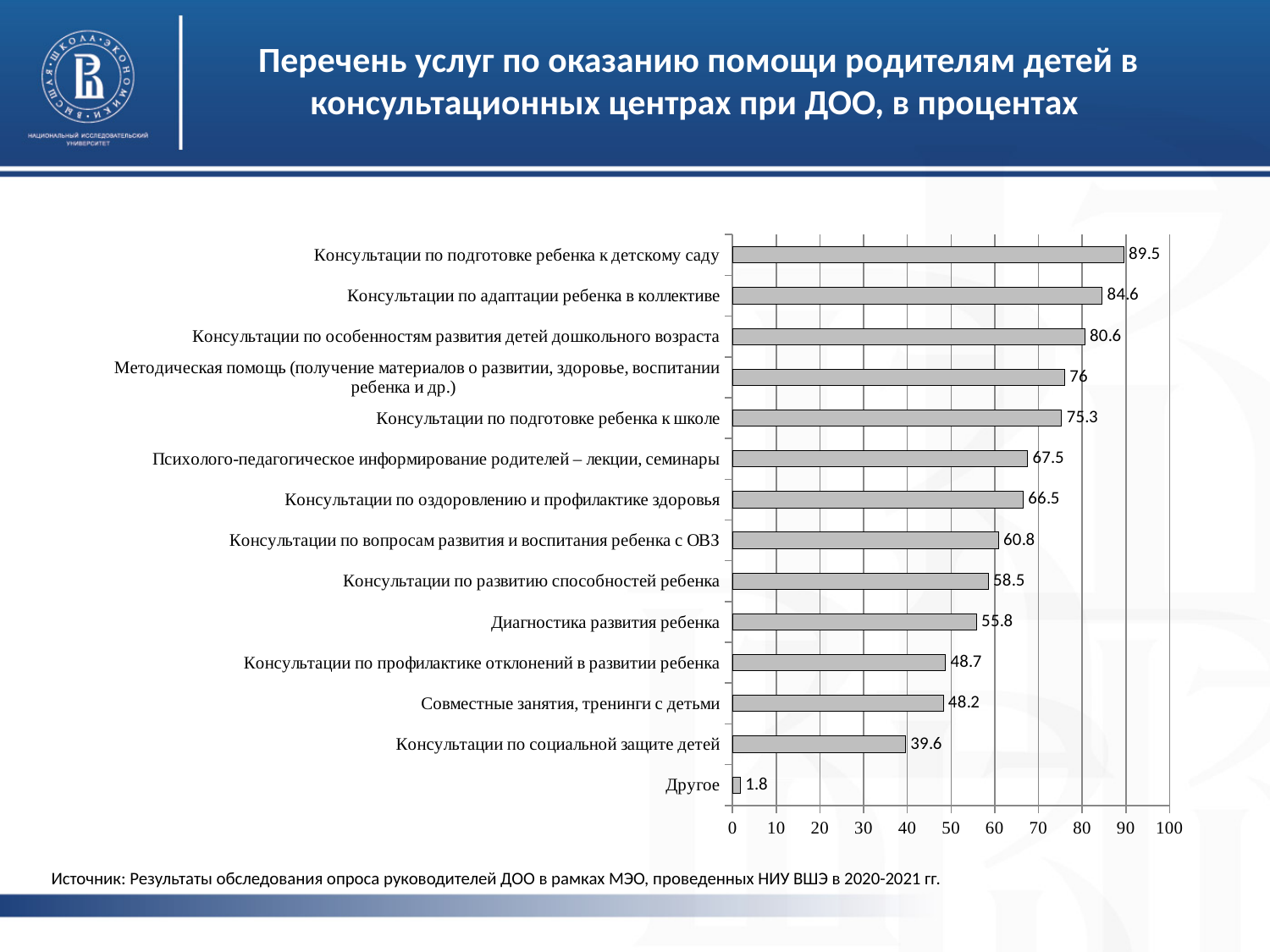
Which is larger: «Консультации по оздоровлению и профилактике здоровья» or «Консультации по вопросам развития и воспитания ребенка с ОВЗ»? Консультации по оздоровлению и профилактике здоровья Is the value for «Совместные занятия, тренинги с детьми» greater or less than 50? less Which category has the highest value? Консультации по подготовке ребенка к детскому саду What is the maximum value shown on the horizontal axis? 100 What kind of chart is shown on the slide? bar chart What is the value for «Консультации по подготовке ребенка к детскому саду»? 89.5 Which category has the lowest value? Другое What is the value for «Консультации по социальной защите детей»? 39.6 What is the value for «Диагностика развития ребенка»? 55.8 What is the difference between «Консультации по подготовке ребенка к детскому саду» and «Консультации по адаптации ребенка в коллективе»? 4.9 How many categories are shown in the chart? 14 What is the difference between «Консультации по профилактике отклонений в развитии ребенка» and «Совместные занятия, тренинги с детьми»? 0.5